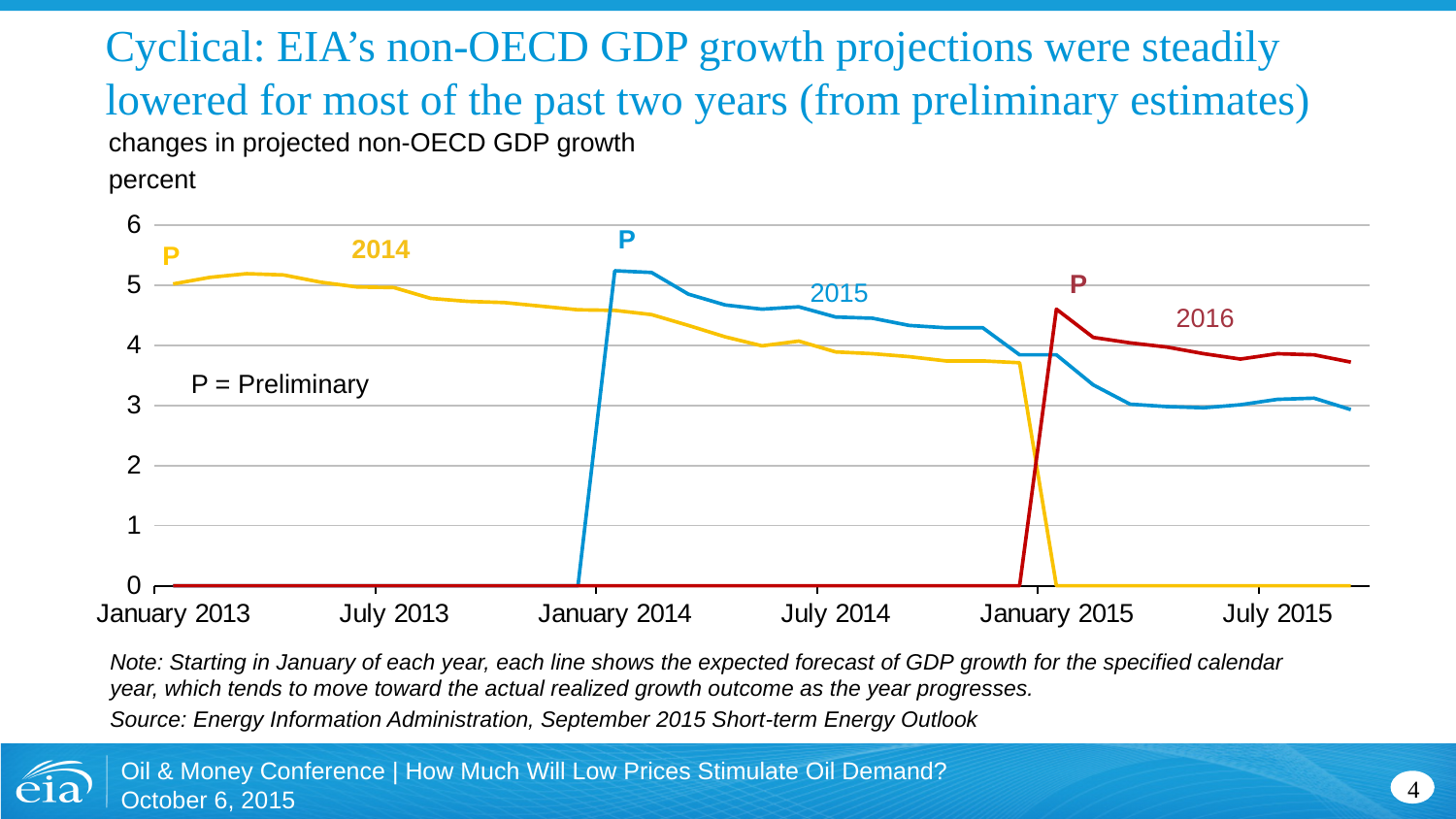
Is the preliminary value of the 2016 line at January 2015 greater or less than 4? greater Which of the three lines has the lowest preliminary (P) starting value? 2016 Does the 2014 line rise or fall between January 2013 and the end of 2014? fall Does the 2015 line rise or fall between January 2014 and July 2015? fall At January 2015, which line is higher: the 2015 line or the 2016 line? 2016 How many projection lines (calendar years) are plotted on the chart? 3 Is the value of the 2015 line at July 2015 greater or less than 4? less Is the value of the 2014 line at January 2014 greater or less than 5? less What does the letter P on the chart stand for? Preliminary Which calendar years are the three lines labelled with? 2014, 2015 and 2016 What kind of chart is shown on the slide? line chart